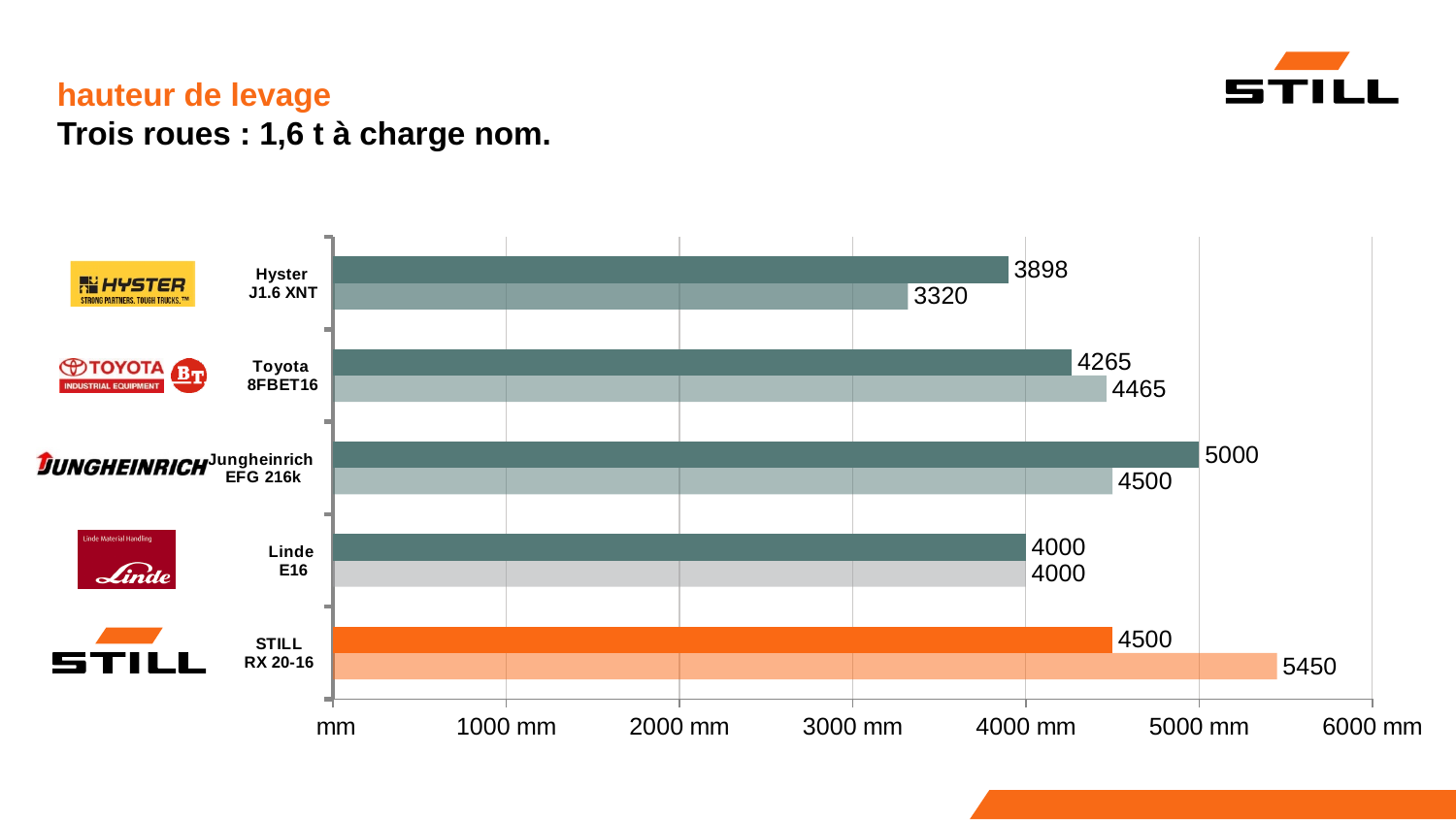
What is the value of the upper bar for Hyster J1.6 XNT? 3898 Which is larger: the upper bar for Toyota 8FBET16 or the upper bar for Linde E16? Toyota 8FBET16 What is the value of the lower bar for Toyota 8FBET16? 4465 What kind of chart is shown on the slide? bar chart Which model has the highest value among the upper bars? Jungheinrich EFG 216k Which model has the lowest value among the lower bars? Hyster J1.6 XNT What is the difference between the upper and lower bar values for Hyster J1.6 XNT? 578 What is the difference between the lower bar values of STILL RX 20-16 and Jungheinrich EFG 216k? 950 What colour are the bars for STILL RX 20-16? orange Is the lower bar value for STILL RX 20-16 greater or less than 5000 mm? greater What is the value of the lower bar for STILL RX 20-16? 5450 How many models are compared in the chart? 5